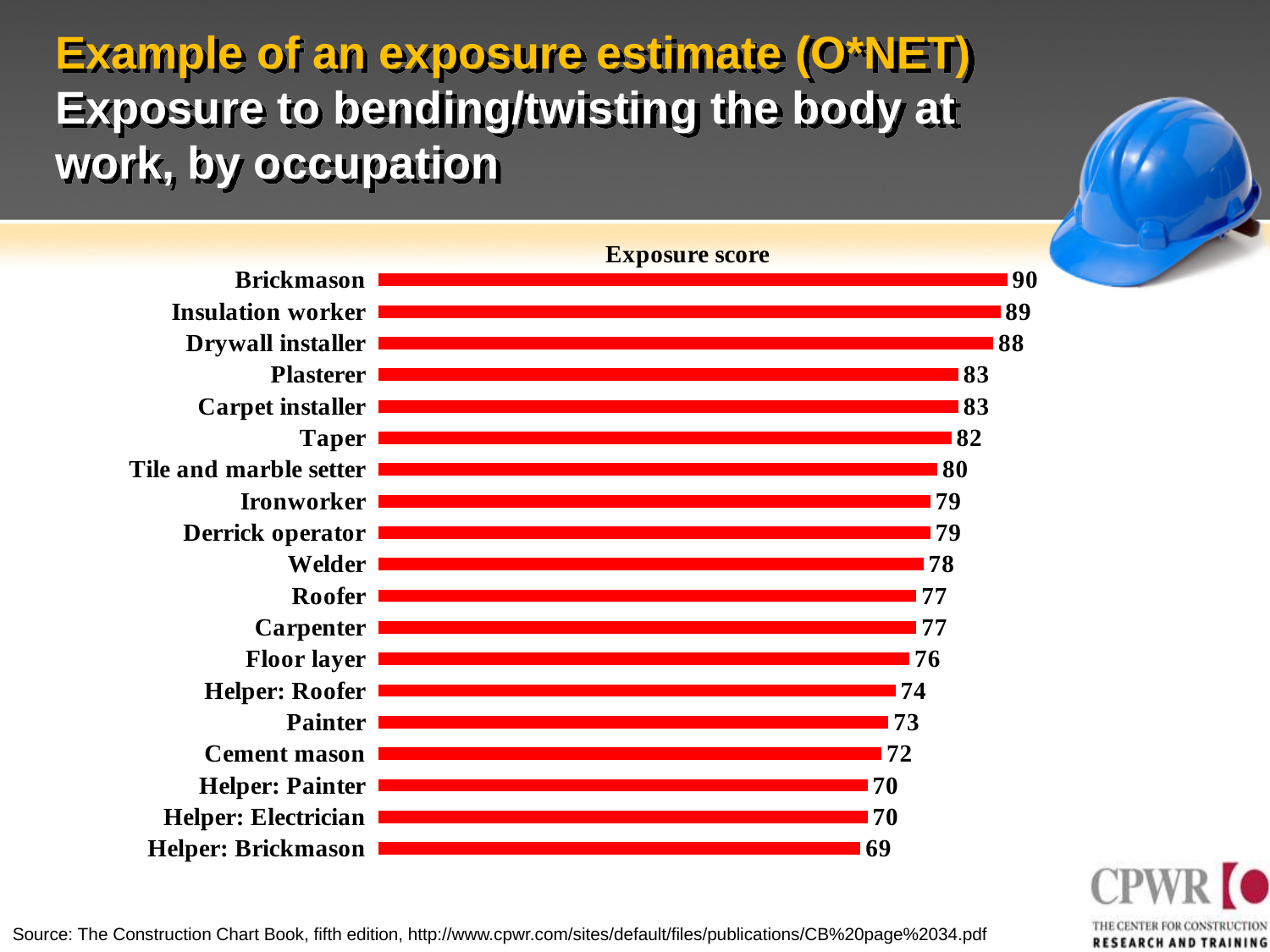
Which has a higher exposure score, Drywall installer or Welder? Drywall installer What is the difference between the exposure scores of Plasterer and Painter? 10 What type of chart is shown on the slide? Bar chart What is the exposure score for Brickmason? 90 What is the exposure score for Helper: Roofer? 74 Which occupation has the highest exposure score? Brickmason What is the exposure score for Tile and marble setter? 80 Which occupation has the lowest exposure score? Helper: Brickmason What is the difference between the exposure scores of Brickmason and Helper: Brickmason? 21 What is the title of the chart? Exposure score Which has a higher exposure score, Cement mason or Floor layer? Floor layer How many occupations are shown in the chart? 19